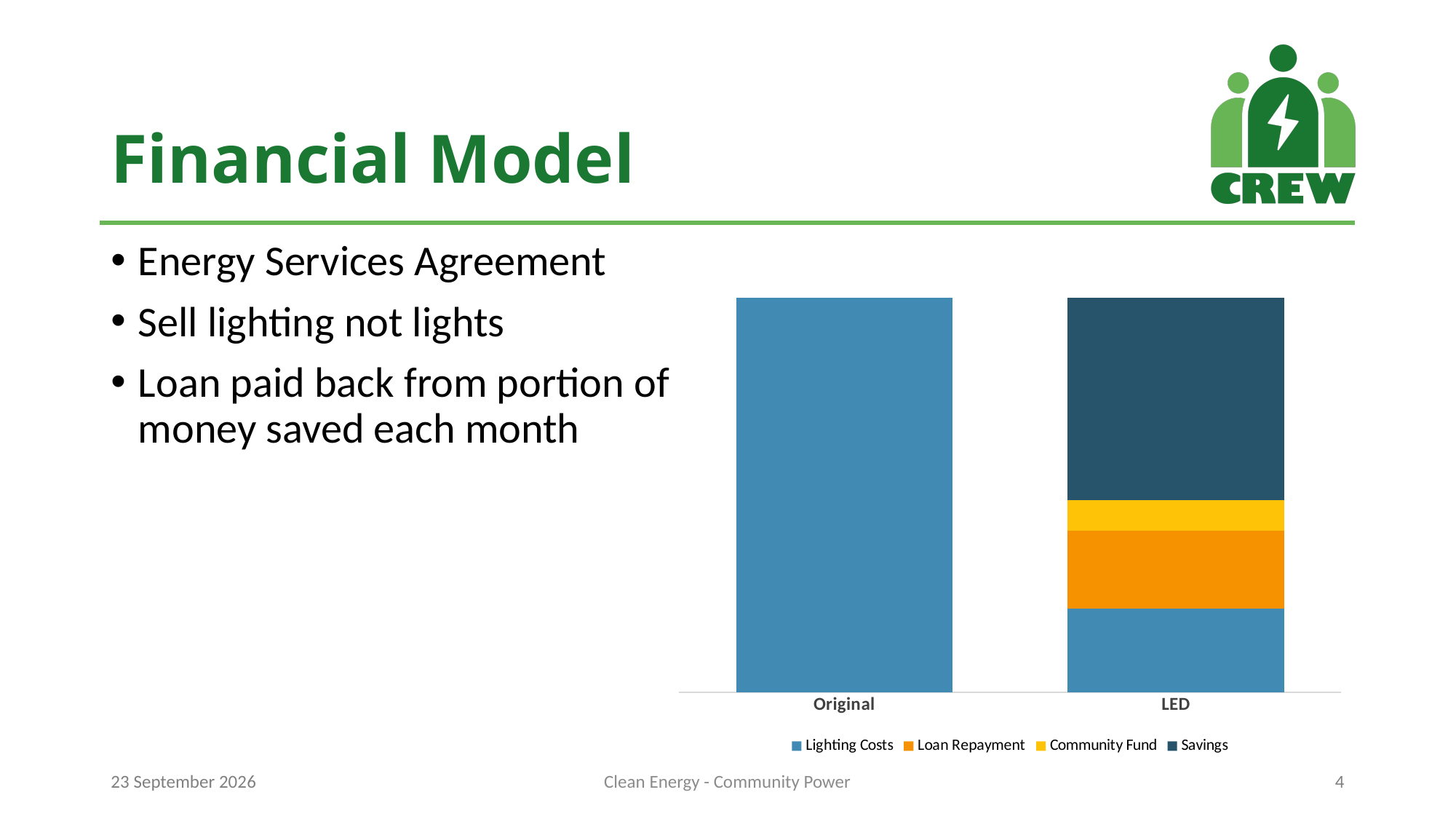
Which series is the only one present in the Original bar? Lighting Costs In the LED bar, is the Loan Repayment segment larger or smaller than the Community Fund segment? Larger How many series segments make up the Original bar? 1 How many series does the chart legend list? 4 Which segment is the largest in the LED bar? Savings Is the Lighting Costs segment larger for Original or for LED? Original How many categories are shown on the x axis of the chart? 2 How many series segments make up the LED bar? 4 Which series is shown in dark teal in the chart legend? Savings Which segment is the smallest in the LED bar? Community Fund What are the two category labels on the x axis of the chart? Original and LED What kind of chart is shown on the slide? Stacked bar chart